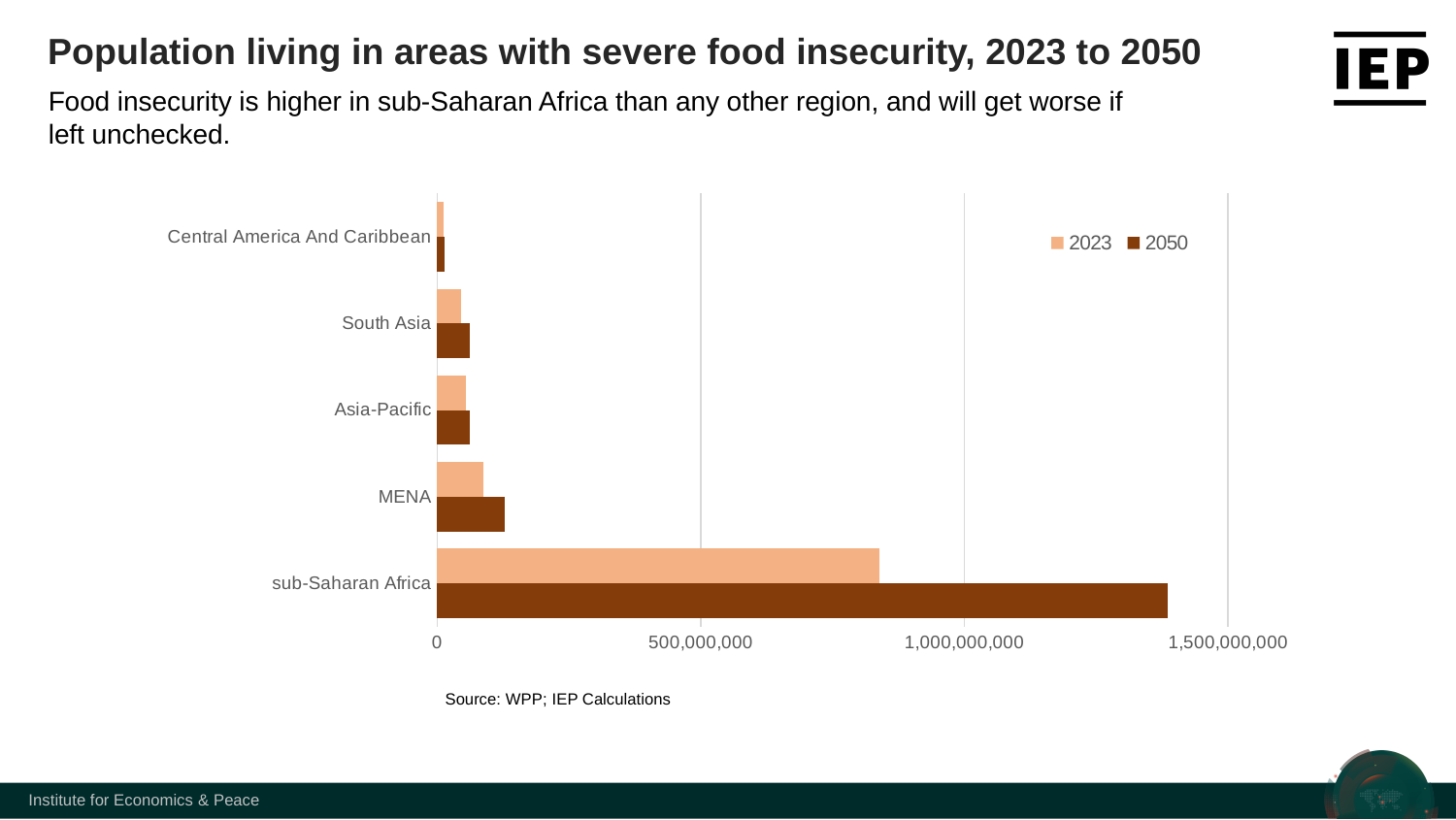
Which region has the lowest population living in areas with severe food insecurity in 2023? Central America And Caribbean Is the 2050 value for sub-Saharan Africa greater or less than 1,000,000,000? greater For sub-Saharan Africa, which year has the larger value, 2023 or 2050? 2050 Is the 2023 value for sub-Saharan Africa greater or less than 500,000,000? greater Which region has the highest population living in areas with severe food insecurity in 2050? sub-Saharan Africa Which region has the larger 2050 value, MENA or Asia-Pacific? MENA Is the 2050 value for MENA greater or less than 500,000,000? less What type of chart is shown on the slide? Bar chart How many series does the legend list? 2 How many regions are shown on the chart? 5 What is the title of the chart? Population living in areas with severe food insecurity, 2023 to 2050